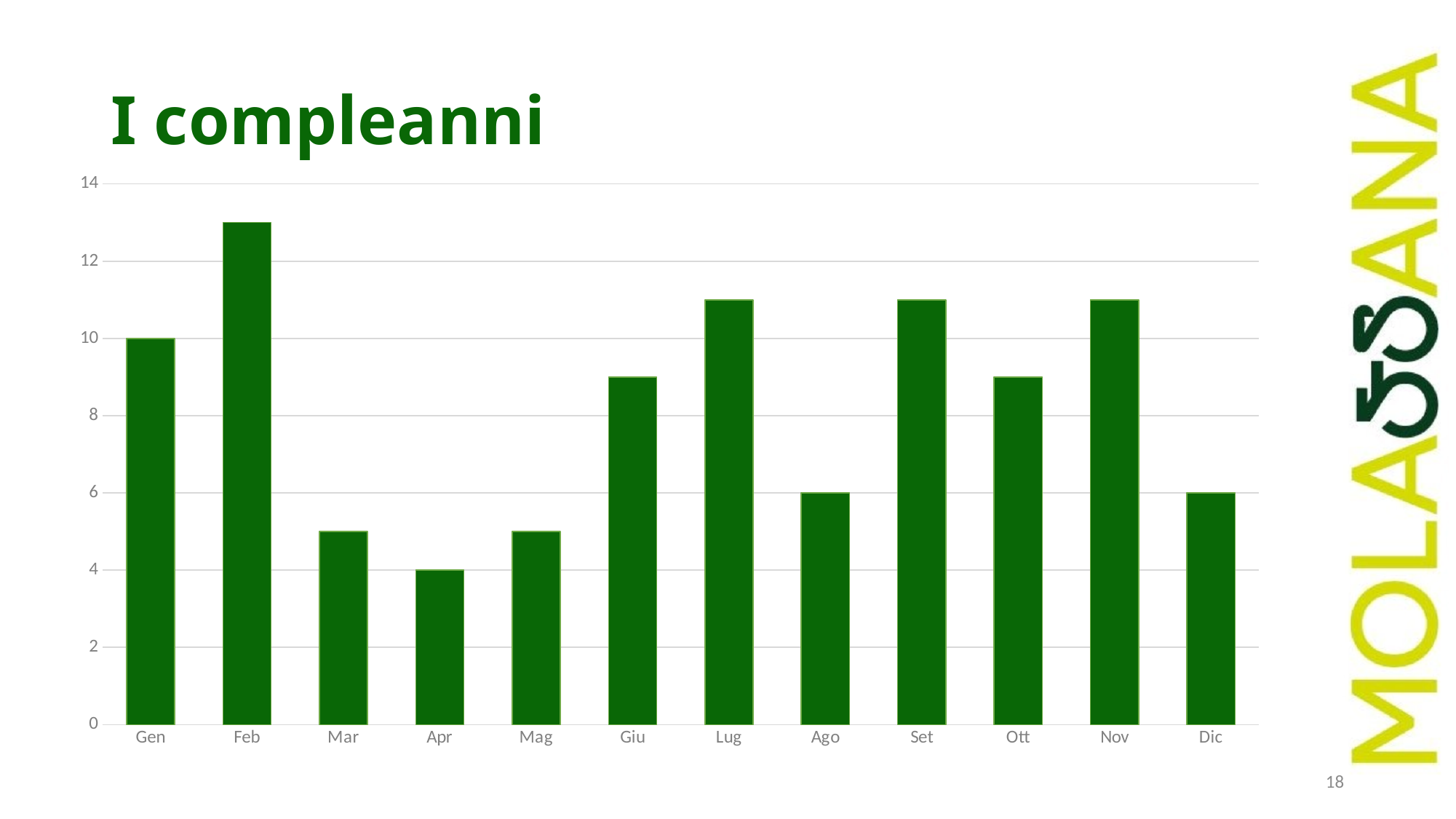
What type of chart is shown on the slide? Bar chart Which is larger, the value for Feb or the value for Gen? Feb Is the value for Mar greater or less than 6? less How many months are shown on the x axis? 12 What is the value for Dic? 6 Is the value for Feb greater or less than 12? greater Which month has the highest bar? Feb Which month has the lowest bar? Apr What is the value for Ago? 6 What is the value for Gen? 10 What is the difference between the values for Gen and Apr? 6 What is the value for Apr? 4